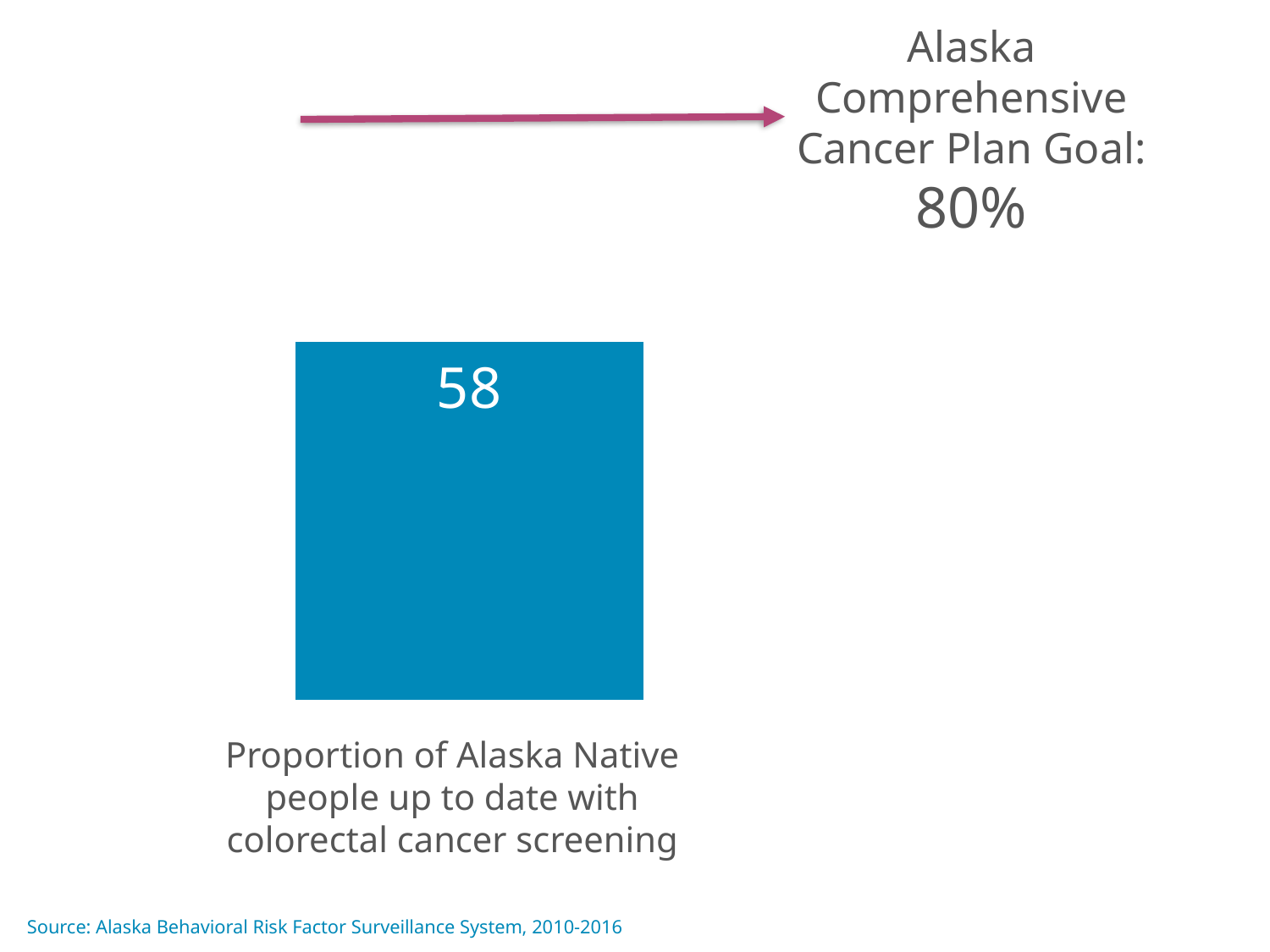
How many bars are plotted in the chart? 1 By how many percentage points does the plotted value of 58 fall short of the 80% goal? 22 Is the plotted value for colorectal cancer screening above or below the Alaska Comprehensive Cancer Plan Goal of 80%? below Is the value for the proportion of Alaska Native people up to date with colorectal cancer screening greater or less than 50? greater What is the Alaska Comprehensive Cancer Plan Goal shown on the slide? 80% What is the source cited for the chart data? Alaska Behavioral Risk Factor Surveillance System, 2010-2016 What value is shown on the bar for the proportion of Alaska Native people up to date with colorectal cancer screening? 58 What kind of chart is shown on the slide? bar chart